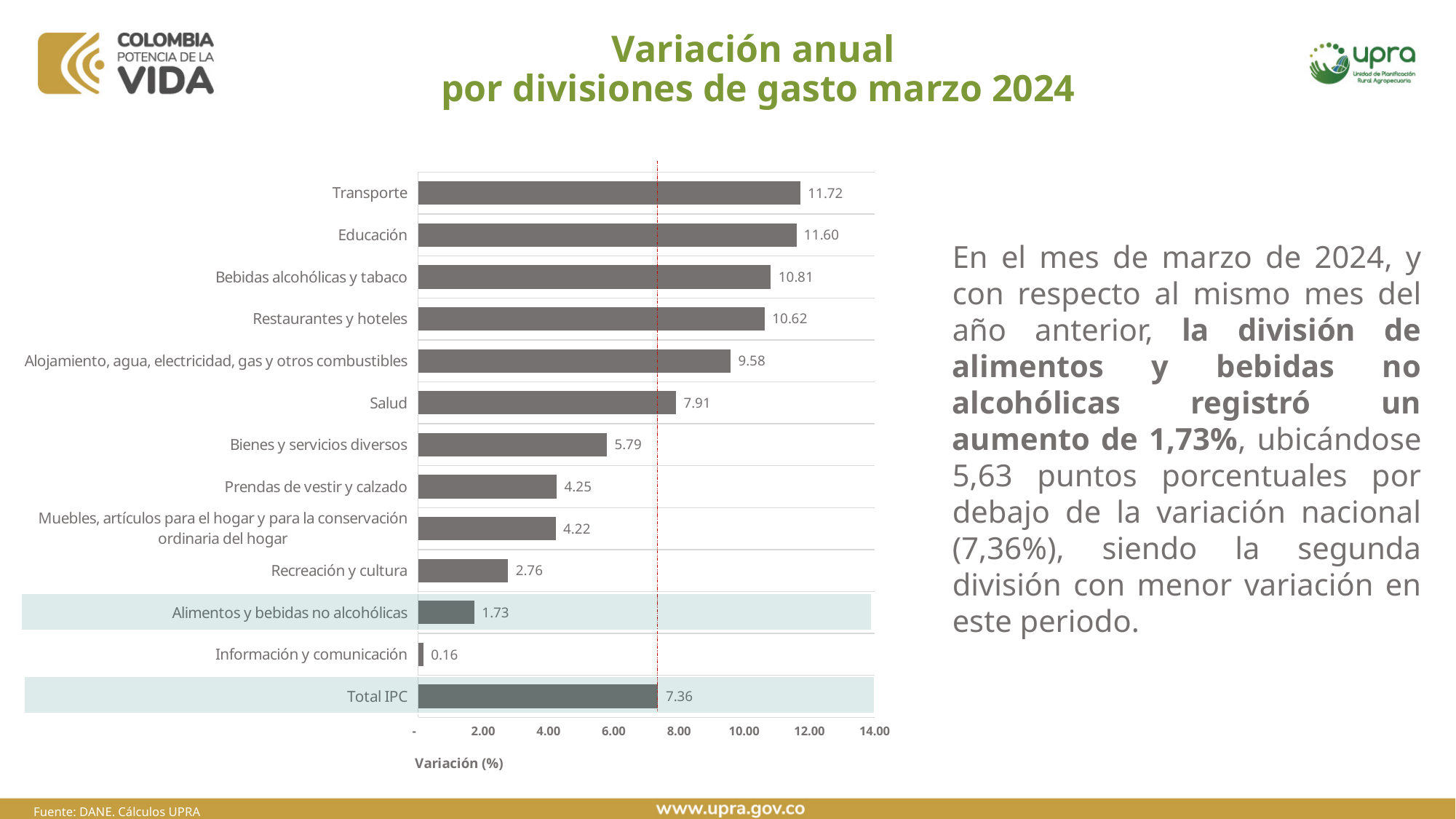
What is the value for Total IPC? 7.36 Which division has the highest value? Transporte Is the value for Alojamiento, agua, electricidad, gas y otros combustibles greater or less than 8.00? greater Which division has the lowest value? Información y comunicación What is the difference between the values for Transporte and Educación? 0.12 How many bars are shown in the chart? 13 What is the label of the x axis? Variación (%) Which is larger, the value for Salud or the value for Bienes y servicios diversos? Salud What is the value for Alimentos y bebidas no alcohólicas? 1.73 What kind of chart is shown on the slide? Bar chart What is the difference between Total IPC and Alimentos y bebidas no alcohólicas? 5.63 What is the value for Transporte? 11.72